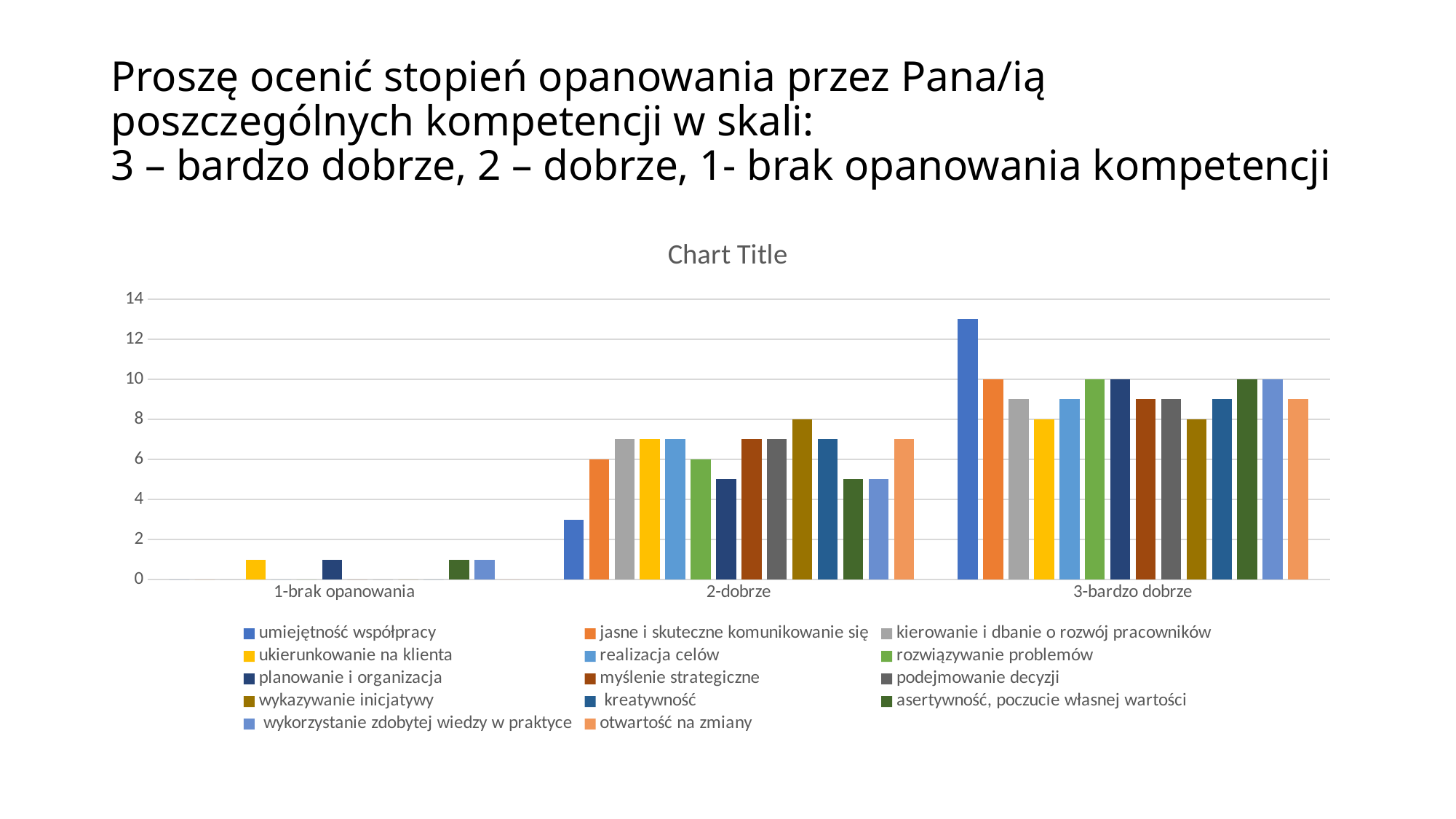
What type of chart is shown on the slide? bar chart What is the value for 'wykazywanie inicjatywy' in the '2-dobrze' category? 8 How many categories are shown on the x axis of the chart? 3 What is the value for 'rozwiązywanie problemów' in the '2-dobrze' category? 6 Which series has the highest bar in the '3-bardzo dobrze' category? umiejętność współpracy What is the title shown above the chart? Chart Title What is the value for 'ukierunkowanie na klienta' in the '3-bardzo dobrze' category? 8 What is the difference between the values for 'jasne i skuteczne komunikowanie się' in '3-bardzo dobrze' and '2-dobrze'? 4 Is the value for 'umiejętność współpracy' in the '3-bardzo dobrze' category greater or less than 12? greater What is the value for 'jasne i skuteczne komunikowanie się' in the '3-bardzo dobrze' category? 10 For 'umiejętność współpracy', do the values rise or fall from '1-brak opanowania' to '3-bardzo dobrze'? rise How many series does the chart legend list? 14